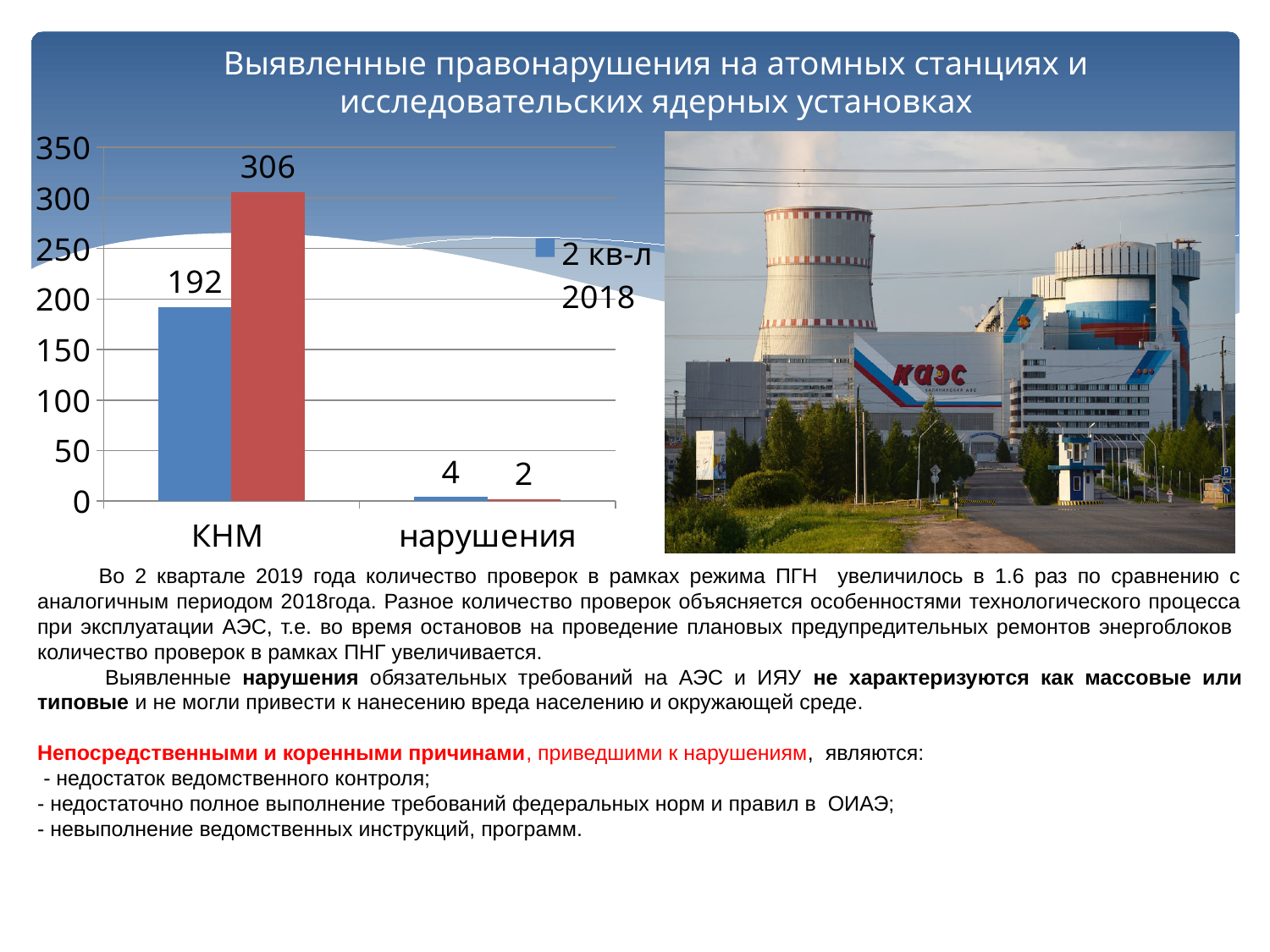
How many bars are plotted on the chart in total? 4 What is the value for КНМ in the 2 кв-л 2018 series? 192 Which category has the higher value in the 2 кв-л 2018 series, КНМ or нарушения? КНМ What is the legend entry that is readable on the chart? 2 кв-л 2018 What is the value for нарушения in the 2 кв-л 2018 series? 4 Is the value for КНМ in the 2 кв-л 2018 series greater or less than 150? greater What is the highest value labelled on the chart? 306 What is the value shown by the red bar for КНМ? 306 How many categories are shown on the x axis of the chart? 2 What kind of chart is shown on the slide? bar chart What is the difference between the КНМ and нарушения values in the 2 кв-л 2018 series? 188 Which category has the lowest value in the 2 кв-л 2018 series? нарушения